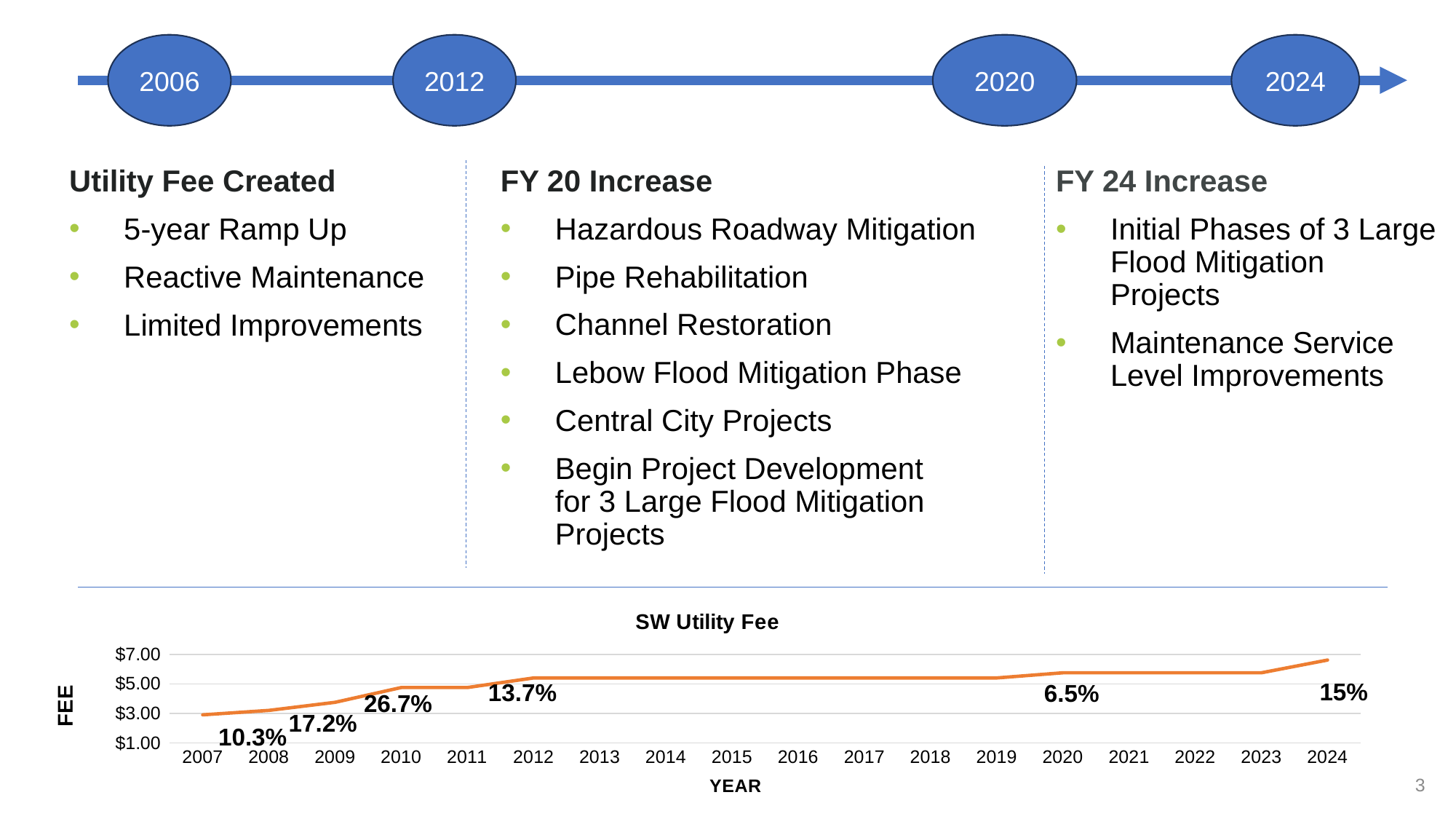
What are the x-axis and y-axis titles of the SW Utility Fee chart? YEAR and FEE What type of chart is the SW Utility Fee chart? line chart Which is larger, the SW Utility Fee in 2012 or in 2008? 2012 Is the SW Utility Fee for 2024 greater or less than $7.00? less What percentage label is printed near 2010 on the SW Utility Fee chart? 26.7% What is the title of the chart at the bottom of the slide? SW Utility Fee Is the SW Utility Fee for 2024 greater or less than $5.00? greater Is the SW Utility Fee for 2009 greater or less than $5.00? less How many years are shown on the x axis of the SW Utility Fee chart? 18 In which year is the SW Utility Fee lowest? 2007 Does the SW Utility Fee generally rise or fall from 2007 to 2024? rise In which year is the SW Utility Fee highest? 2024